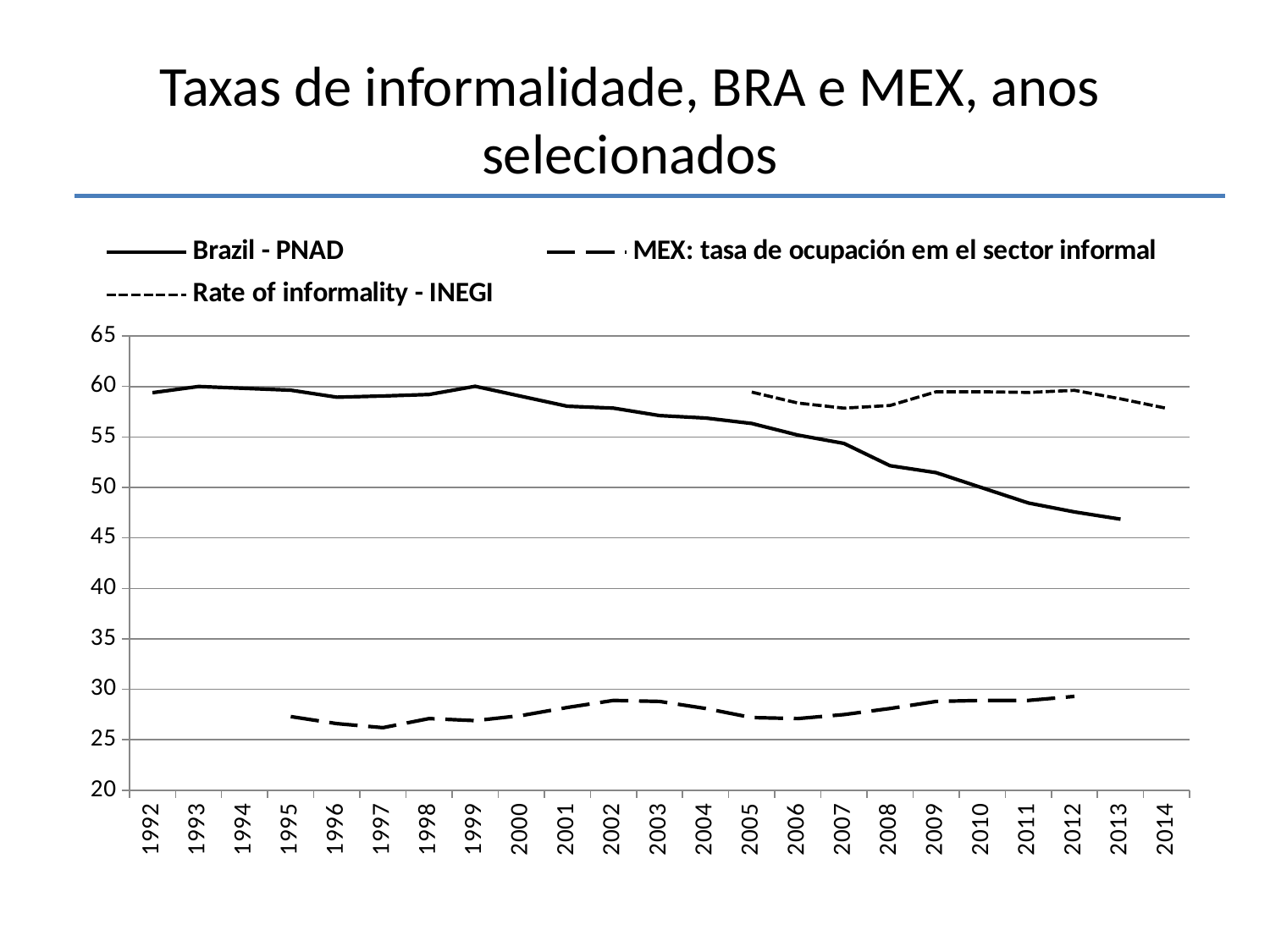
How many series does the legend list? 3 In 2012, which is larger: Brazil - PNAD or Rate of informality - INEGI? Rate of informality - INEGI Which series is drawn with a solid line? Brazil - PNAD Is the Rate of informality - INEGI value for 2014 greater or less than 60? less Does the Brazil - PNAD series rise or fall between 1999 and 2013? fall How many years are labelled on the x axis? 23 What is the title of the slide? Taxas de informalidade, BRA e MEX, anos selecionados Is the Brazil - PNAD value for 2013 greater or less than 50? less What kind of chart is shown on the slide? line chart For Brazil - PNAD, which is larger: the value in 1999 or the value in 2013? 1999 Is the value for MEX: tasa de ocupación em el sector informal in 2002 greater or less than 30? less